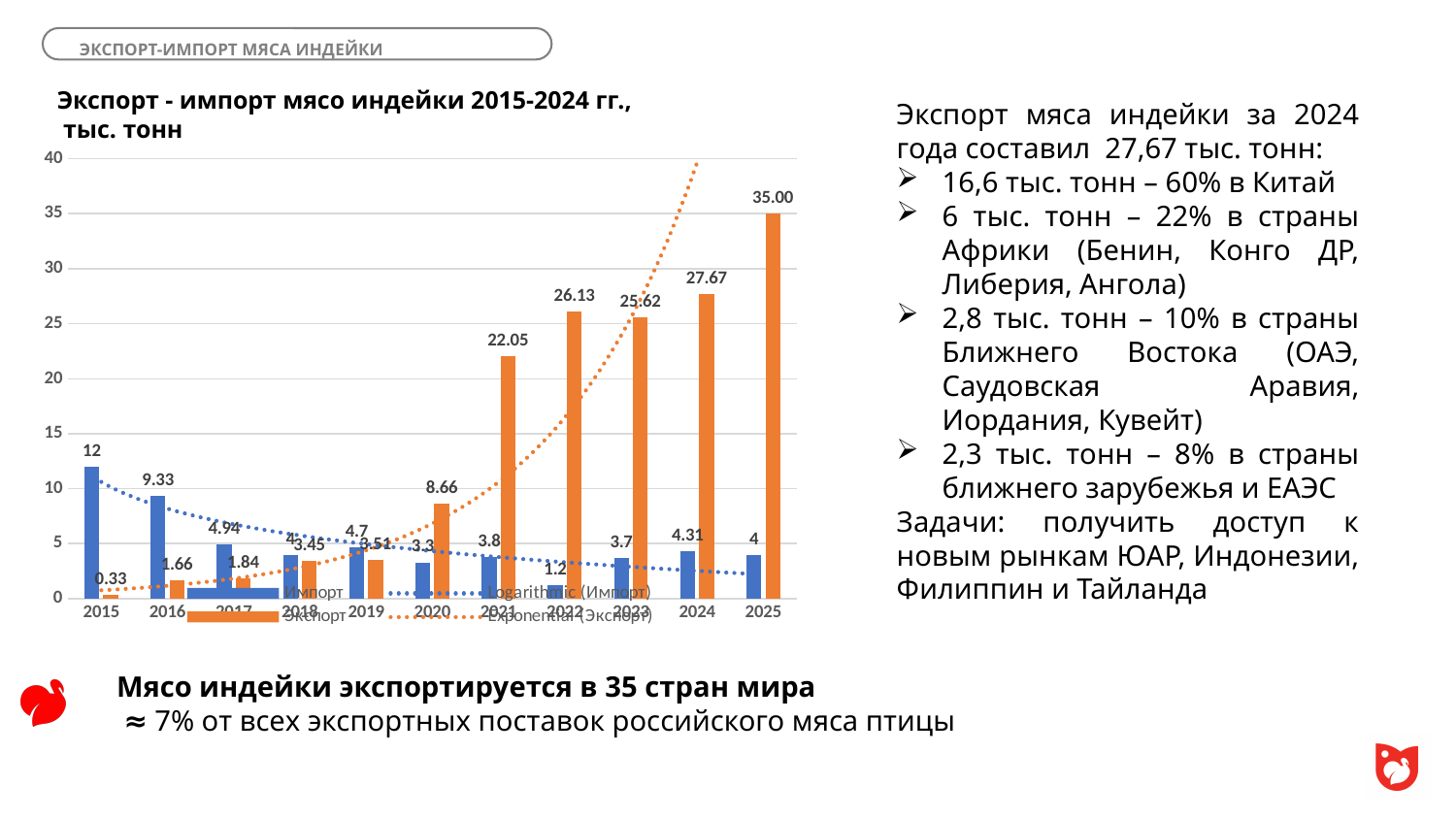
Which year has the lowest export value? 2015 Which year has the highest import value? 2015 How many years are shown on the x axis? 11 What is the difference between the import values for 2015 and 2016? 2.67 In 2021, which is larger: import or export? Export What is the export value for 2024? 27.67 In 2016, which is larger: import or export? Import Do the export values generally rise or fall from 2015 to 2025? Rise Which year has the highest export value? 2025 What is the export value for 2020? 8.66 What is the difference between the export values for 2025 and 2024? 7.33 What is the import value for 2015? 12